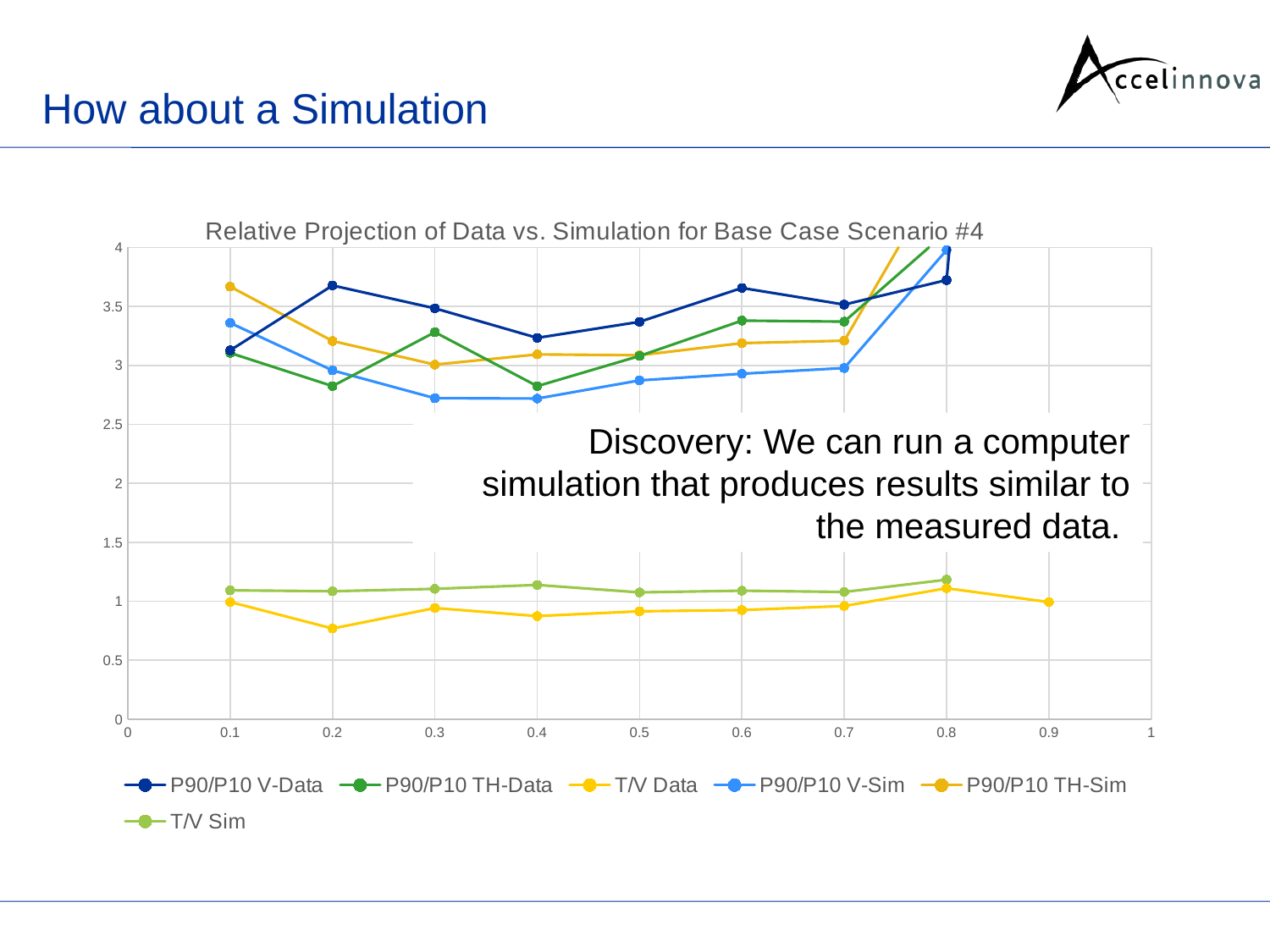
Which series is the only one with a data point at x = 0.9? T/V Data How many data points are plotted for the T/V Data series? 9 At x = 0.1, which series has the highest value? P90/P10 TH-Sim How many series does the chart legend list? 6 What kind of chart is shown on the slide? line chart Is the value for T/V Data at x = 0.2 greater or less than 1? less Is the value for P90/P10 V-Sim at x = 0.3 greater or less than 3? less Is the value for P90/P10 V-Data at x = 0.2 greater or less than 3.5? greater What is the title of the chart? Relative Projection of Data vs. Simulation for Base Case Scenario #4 At x = 0.3, which is larger: P90/P10 V-Data or P90/P10 V-Sim? P90/P10 V-Data At x = 0.1, which series has the lowest value? T/V Data